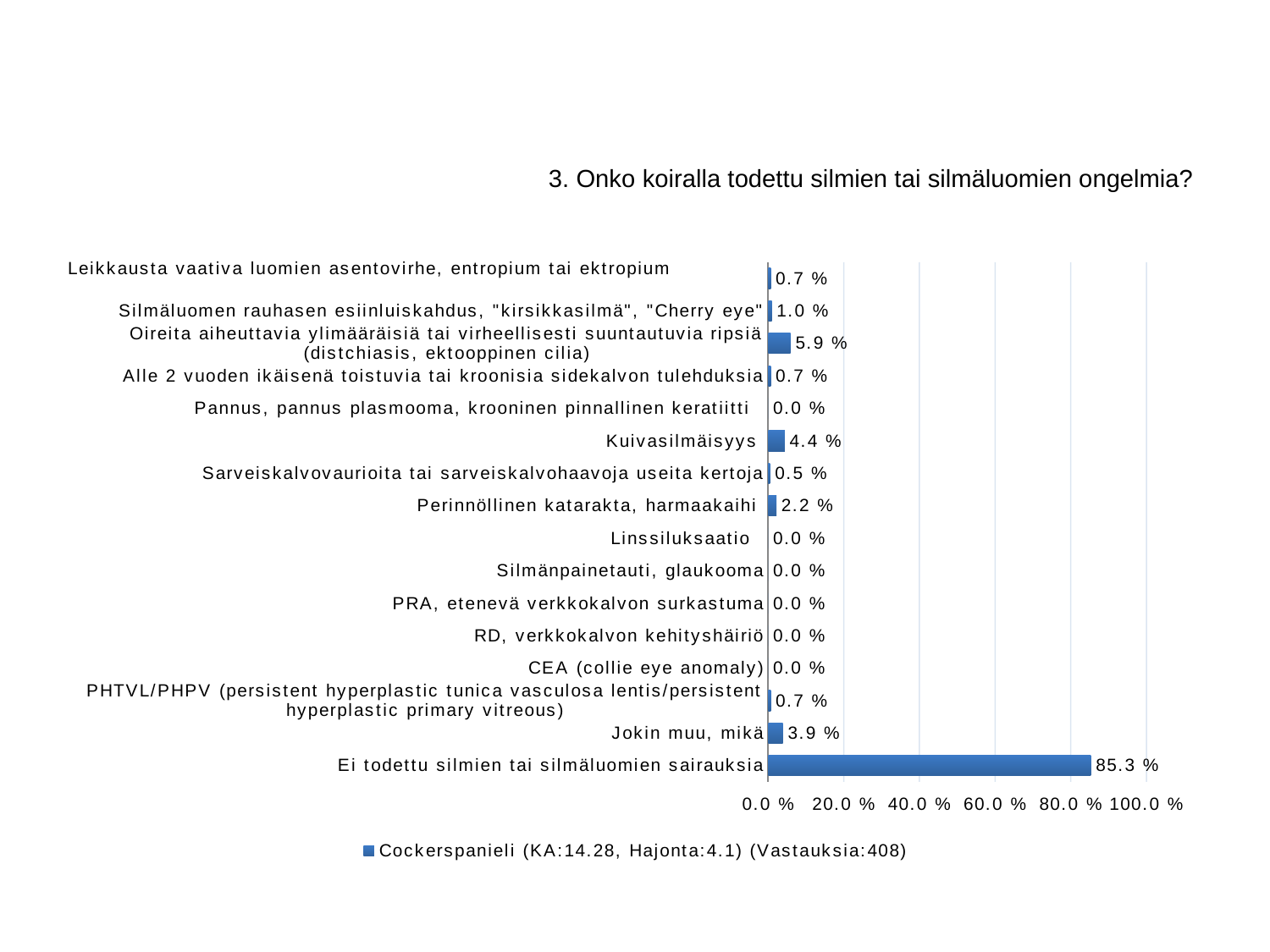
How many series does the legend list? 1 What is the title of the chart? 3. Onko koiralla todettu silmien tai silmäluomien ongelmia? What kind of chart is shown on the slide? bar chart What is the value for "Kuivasilmäisyys"? 4.4 % What is the value for "Perinnöllinen katarakta, harmaakaihi"? 2.2 % What is the value for "Ei todettu silmien tai silmäluomien sairauksia"? 85.3 % Is the value for "Ei todettu silmien tai silmäluomien sairauksia" greater or less than 80.0 %? greater Which is larger, the value for "Jokin muu, mikä" or the value for "Perinnöllinen katarakta, harmaakaihi"? Jokin muu, mikä Which category has the highest value? Ei todettu silmien tai silmäluomien sairauksia How many categories are shown in the chart? 16 What is the difference between the values for "Oireita aiheuttavia ylimääräisiä tai virheellisesti suuntautuvia ripsiä (distchiasis, ektooppinen cilia)" and "Kuivasilmäisyys"? 1.5 % What is the value for "Jokin muu, mikä"? 3.9 %